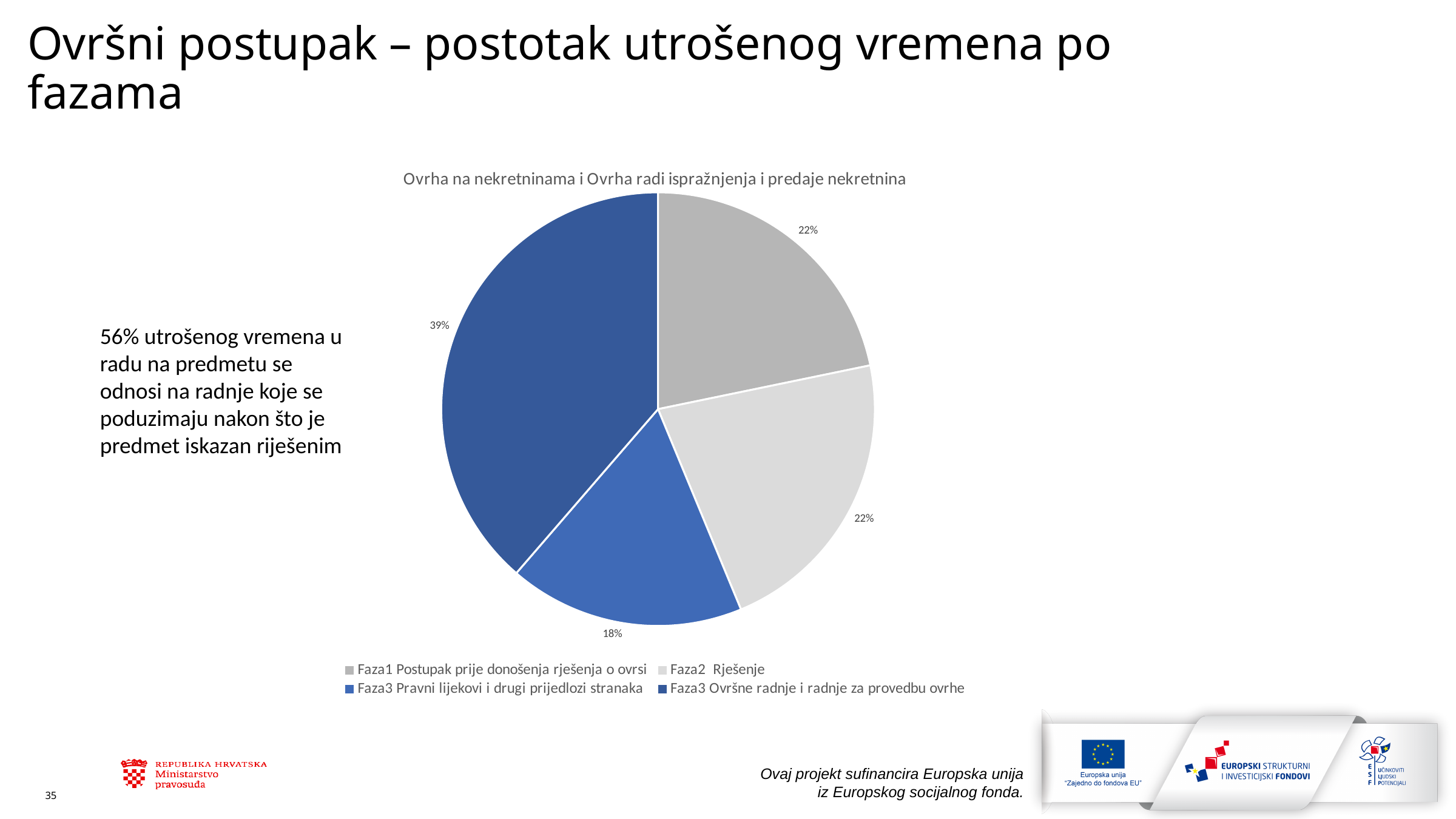
What percentage of the pie is labelled for Faza1 Postupak prije donošenja rješenja o ovrsi? 22% How many slices does the pie chart have? 4 Which slice of the pie is the smallest? Faza3 Pravni lijekovi i drugi prijedlozi stranaka What type of chart is shown on the slide? pie chart What percentage of the pie is labelled for Faza2 Rješenje? 22% What is the difference in percentage points between the Faza3 Ovršne radnje i radnje za provedbu ovrhe slice and the Faza3 Pravni lijekovi i drugi prijedlozi stranaka slice? 21 What percentage of the pie is labelled for Faza3 Ovršne radnje i radnje za provedbu ovrhe? 39% Which is larger: the Faza2 Rješenje slice or the Faza3 Pravni lijekovi i drugi prijedlozi stranaka slice? Faza2 Rješenje What is the title of the chart? Ovrha na nekretninama i Ovrha radi ispražnjenja i predaje nekretnina Which slice of the pie is the largest? Faza3 Ovršne radnje i radnje za provedbu ovrhe How many entries does the chart legend list? 4 What percentage of the pie is labelled for Faza3 Pravni lijekovi i drugi prijedlozi stranaka? 18%